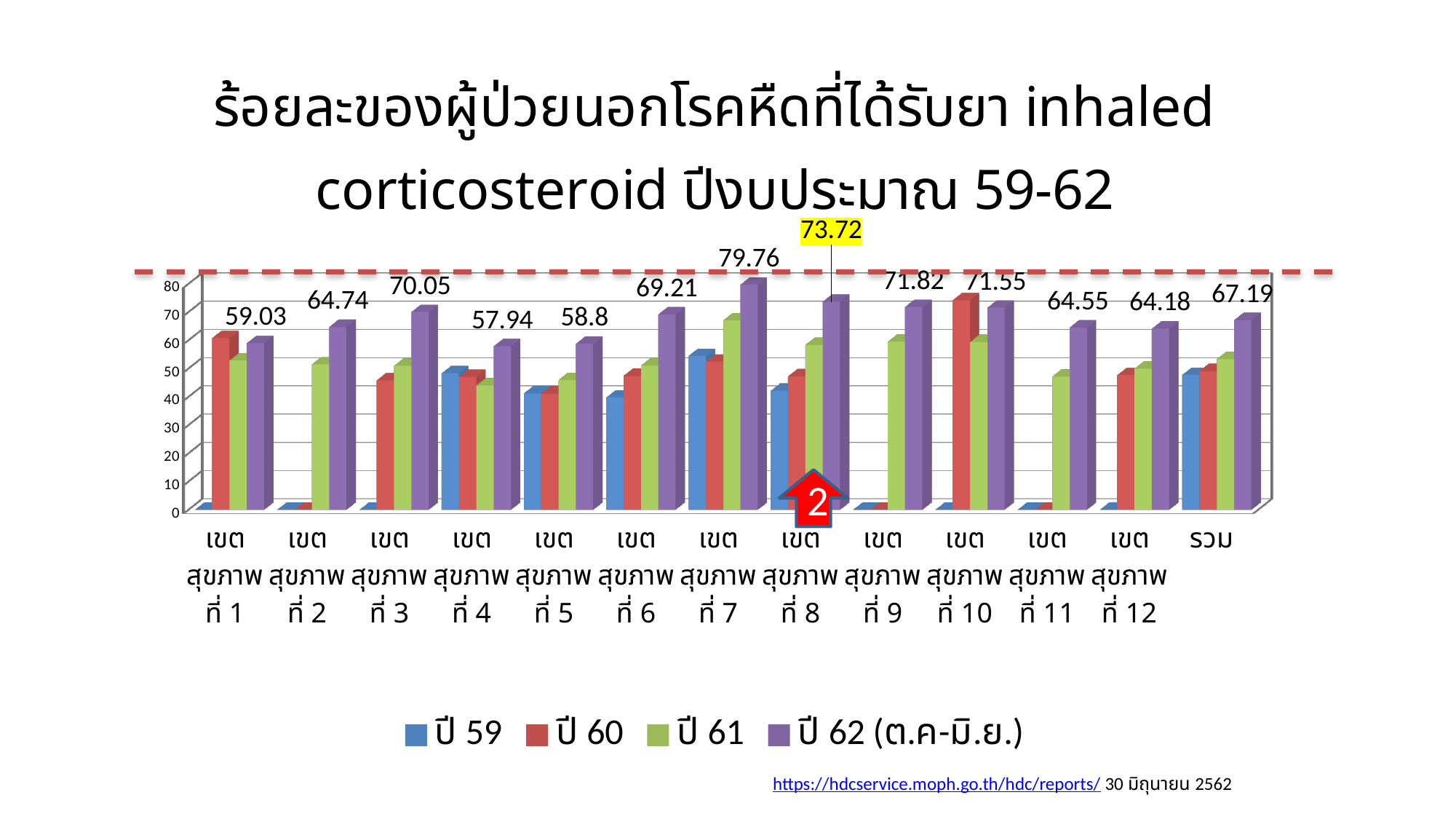
How many categories are shown on the x axis? 13 What is the value for ปี 62 (ต.ค-มิ.ย.) in รวม? 67.19 Which category has the highest value for ปี 62 (ต.ค-มิ.ย.)? เขตสุขภาพที่ 7 What is the value for ปี 62 (ต.ค-มิ.ย.) in เขตสุขภาพที่ 4? 57.94 What is the value for ปี 62 (ต.ค-มิ.ย.) in เขตสุขภาพที่ 7? 79.76 What is the value for ปี 62 (ต.ค-มิ.ย.) in เขตสุขภาพที่ 8? 73.72 Which category has the lowest value for ปี 62 (ต.ค-มิ.ย.)? เขตสุขภาพที่ 4 Is the value for ปี 60 in เขตสุขภาพที่ 10 greater or less than 60? greater Which is larger, the ปี 62 (ต.ค-มิ.ย.) value for เขตสุขภาพที่ 3 or for เขตสุขภาพที่ 6? เขตสุขภาพที่ 3 What kind of chart is shown on the slide? bar chart What is the difference between the ปี 62 (ต.ค-มิ.ย.) values for เขตสุขภาพที่ 7 and เขตสุขภาพที่ 8? 6.04 How many series does the legend list? 4